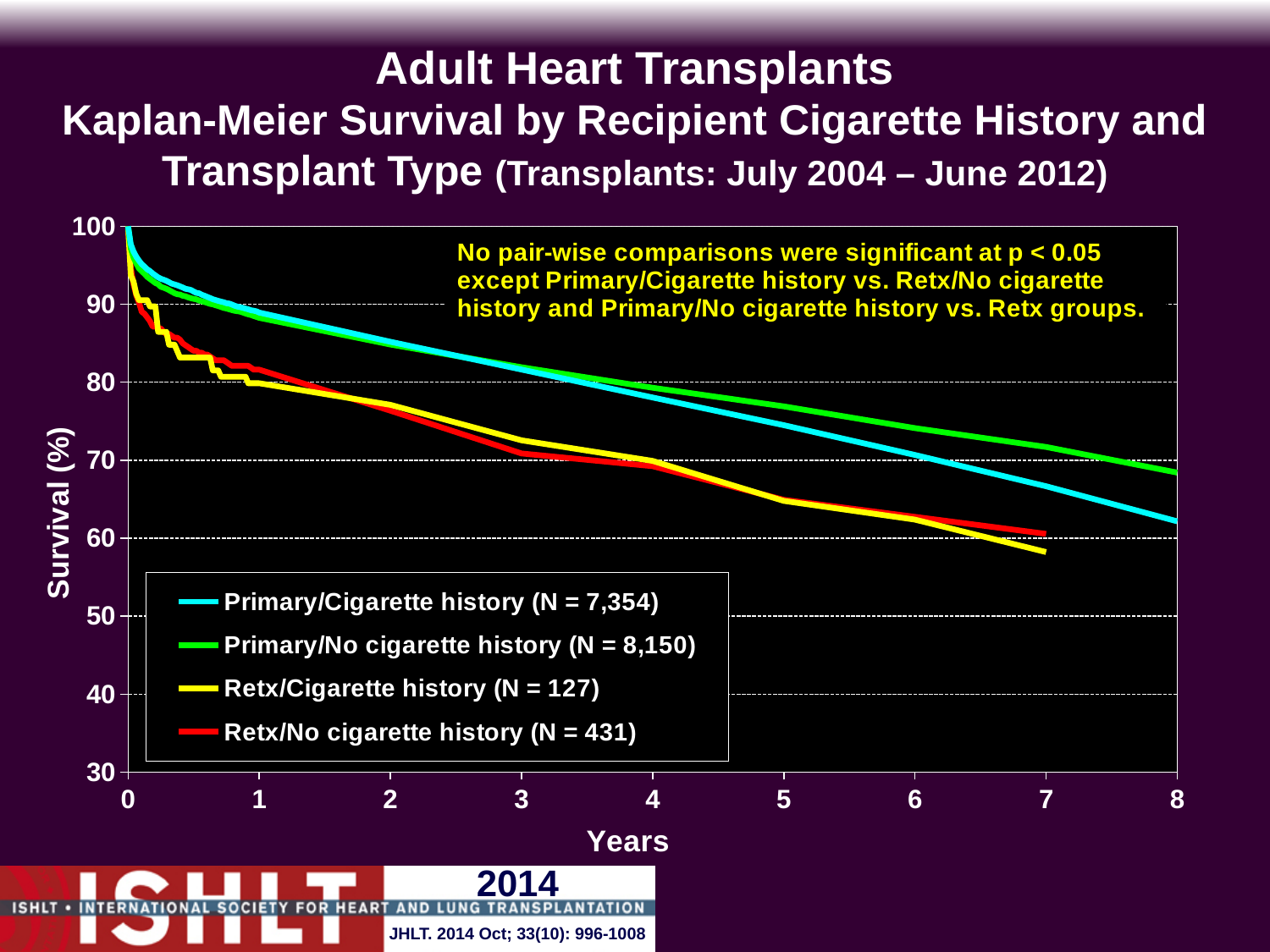
Is the survival value for Retx/Cigarette history at 7 years greater or less than 60? less Is the survival value for Primary/No cigarette history at 5 years greater or less than 70? greater What is the N for the Primary/Cigarette history group shown in the legend? 7,354 How many series does the legend list? 4 At 8 years, which has higher survival: Primary/Cigarette history or Primary/No cigarette history? Primary/No cigarette history Do the survival curves rise or fall as years increase? Fall What is the N for the Retx/Cigarette history group shown in the legend? 127 What is the N for the Retx/No cigarette history group shown in the legend? 431 What colour is the line for Primary/Cigarette history? Cyan Which group has the lowest survival at 7 years? Retx/Cigarette history What kind of chart is shown on the slide? Line chart Is the survival value for Primary/No cigarette history at 8 years greater or less than 60? greater